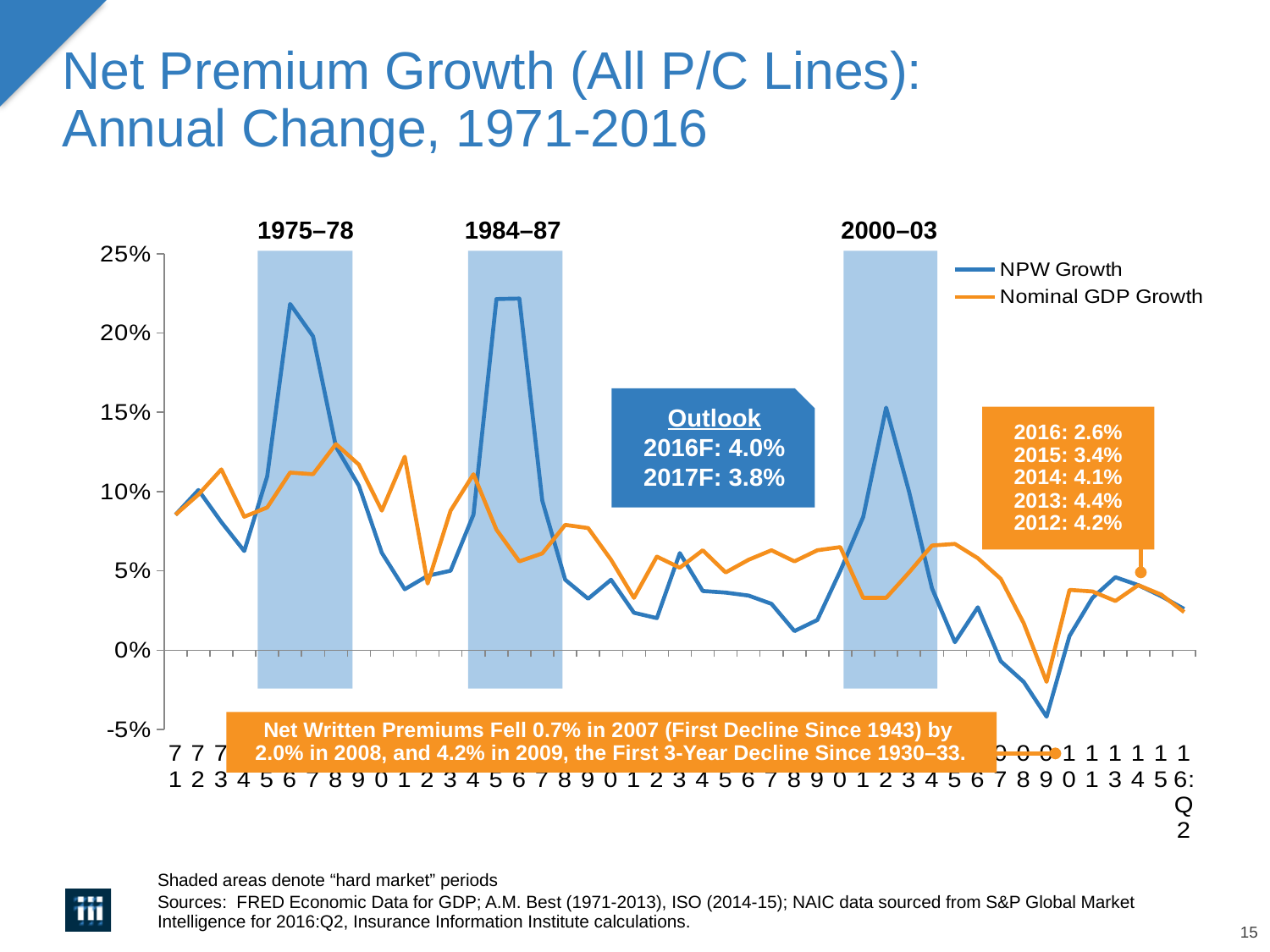
What kind of chart is shown on the slide? Line chart What was net premium growth in 2016 according to the callout box? 2.6% Among the years 2012 to 2016 listed in the callout box, which year had the highest net premium growth? 2013 Which is larger: the actual 2016 net premium growth or the 2016F outlook value? The 2016F outlook (4.0%) What are the two series named in the legend? NPW Growth and Nominal GDP Growth How many series does the legend list? 2 What is the 2017F outlook value for net premium growth? 3.8% How many shaded "hard market" periods are marked on the chart? 3 Is the peak NPW Growth value during the 1984–87 shaded period greater or less than 20%? greater What is the difference between net premium growth in 2013 (4.4%) and 2012 (4.2%)? 0.2 percentage points Among the years 2012 to 2016 listed in the callout box, which year had the lowest net premium growth? 2016 What was net premium growth in 2013 according to the callout box? 4.4%